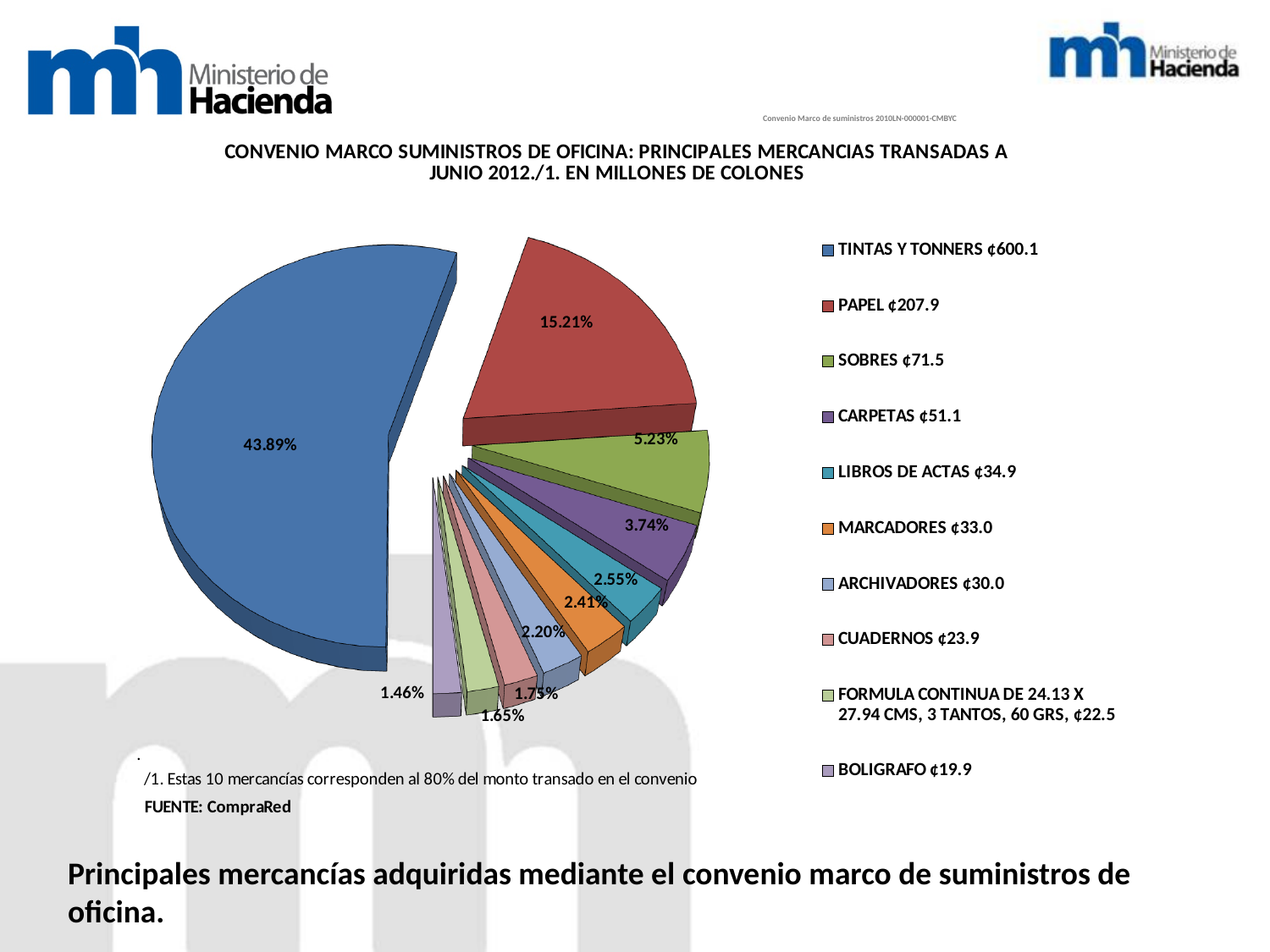
What is the value shown in the legend for CUADERNOS? ¢23.9 What percentage of the pie does TINTAS Y TONNERS represent? 43.89% Which is larger, the value for SOBRES or the value for CARPETAS? SOBRES How many categories (slices) does the pie chart have? 10 Which category has the largest value? TINTAS Y TONNERS What is the value shown in the legend for LIBROS DE ACTAS? ¢34.9 What is the difference in percentage points between the TINTAS Y TONNERS slice and the PAPEL slice? 28.68% What percentage of the pie does SOBRES represent? 5.23% What is the difference between the values for TINTAS Y TONNERS and PAPEL? ¢392.2 What is the value shown in the legend for PAPEL? ¢207.9 Which category has the smallest value? BOLIGRAFO What kind of chart is shown on the slide? pie chart